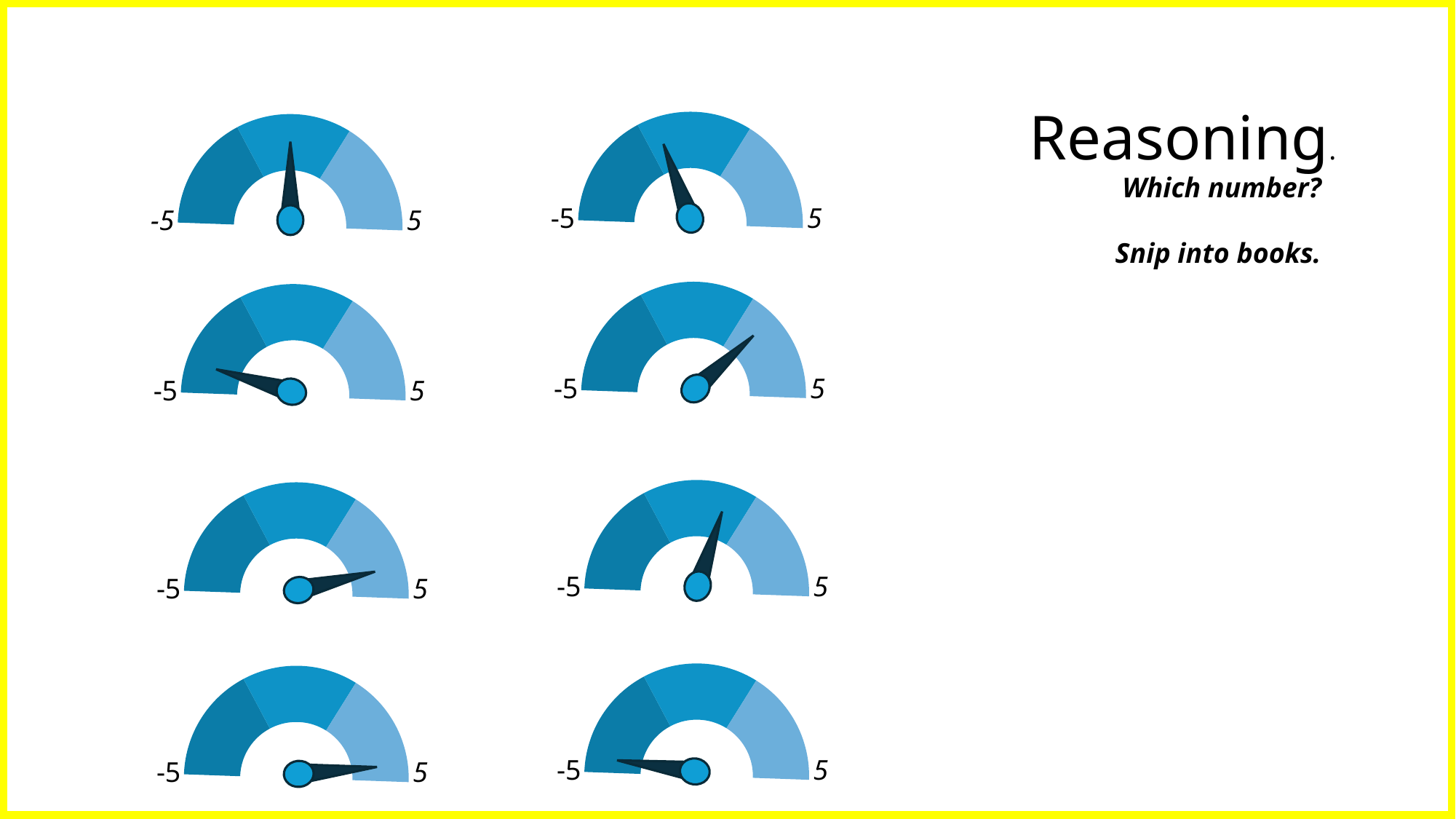
How many gauge charts are shown on the slide? 8 What kind of chart is used on the slide? Gauge chart In the bottom row, does the left gauge's needle point to a higher or lower value than the right gauge's needle? higher In the third row, does the left gauge's needle point to a higher or lower value than the right gauge's needle? higher Does the needle of the second-row right gauge point to a higher or lower value than the needle of the bottom-right gauge? higher What is the highest value labelled on each gauge? 5 What is the lowest value labelled on each gauge? -5